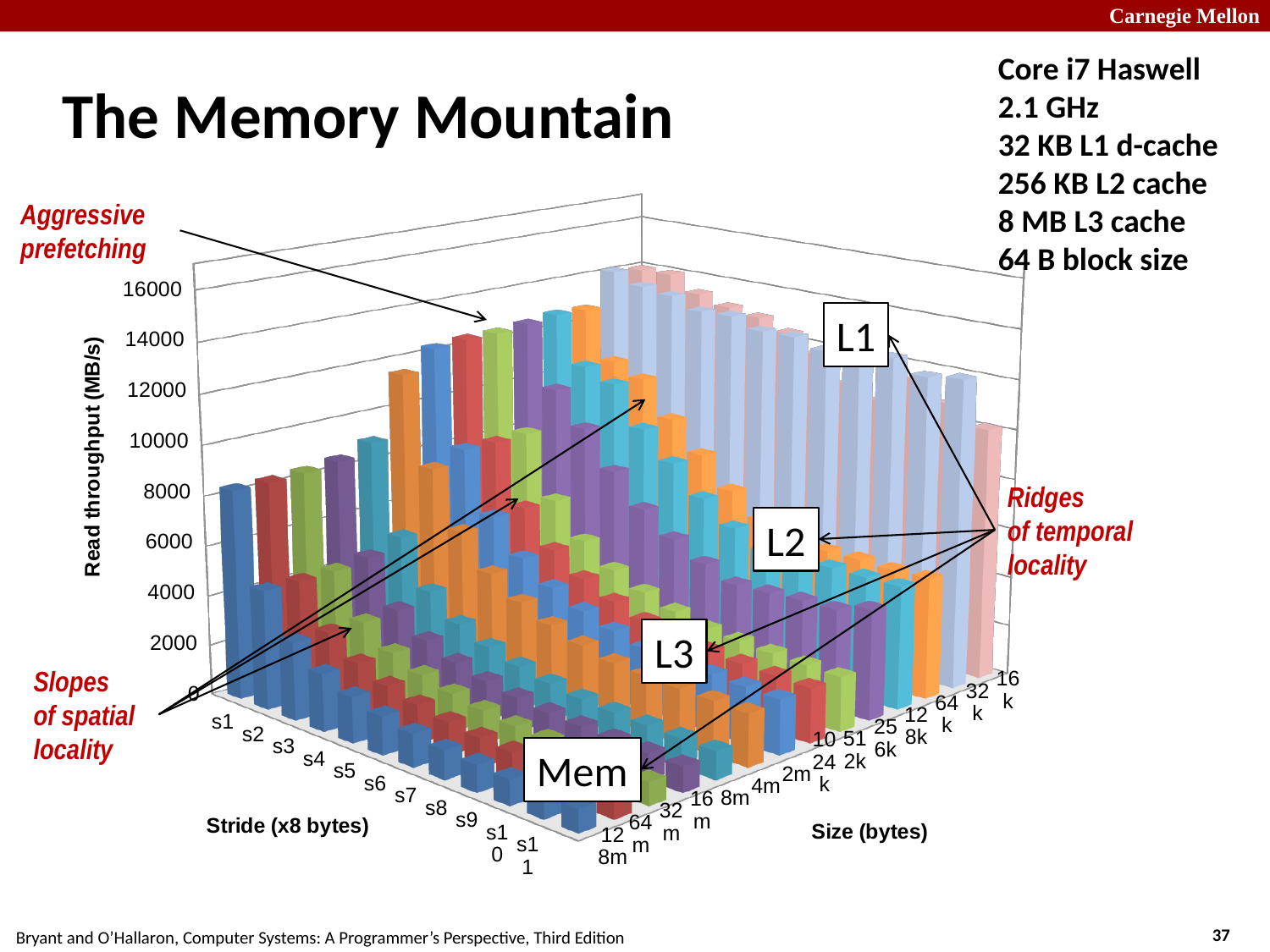
For size 128m, does read throughput rise or fall as the stride increases from s1 to s11? fall What is the label of the vertical axis of the chart? Read throughput (MB/s) For stride s1, does read throughput rise or fall as the size decreases from 128m toward 16k? rise Which stride has the higher read throughput at size 128m: s1 or s11? s1 How many stride categories (s1, s2, ...) are shown along the stride axis? 11 What is the title of the chart on the slide? The Memory Mountain Is the read throughput for stride s11 at size 128m greater or less than 2000 MB/s? less Which size has the higher read throughput at stride s1: 16k or 128m? 16k What kind of chart is shown on the slide? bar chart How many size categories are shown along the Size (bytes) axis? 14